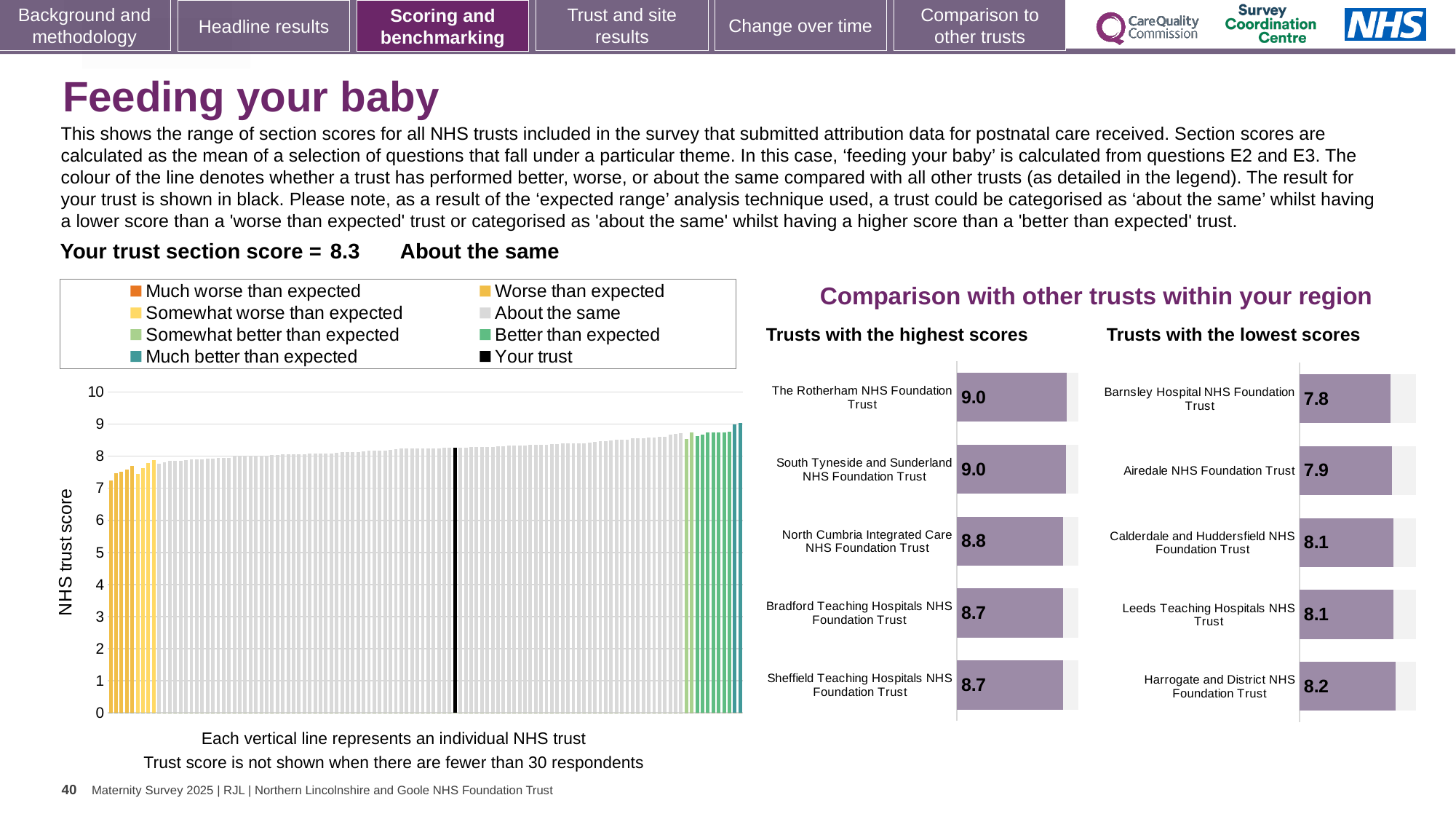
How many entries does the legend of the main 'NHS trust score' chart list? 8 In the 'Trusts with the highest scores' chart, what is the score for North Cumbria Integrated Care NHS Foundation Trust? 8.8 In the 'Trusts with the lowest scores' chart, which has the higher score: Airedale NHS Foundation Trust or Calderdale and Huddersfield NHS Foundation Trust? Calderdale and Huddersfield NHS Foundation Trust In the main 'NHS trust score' chart, do the values rise or fall from left to right? Rise What is the section score for your trust shown on the slide? 8.3 In the main 'NHS trust score' chart, is the value of the leftmost bar greater or less than 8? less How many trusts are shown in the 'Trusts with the highest scores' chart? 5 In the 'Trusts with the lowest scores' chart, which trust has the highest score? Harrogate and District NHS Foundation Trust In the 'Trusts with the lowest scores' chart, what is the difference between the scores of Harrogate and District NHS Foundation Trust and Barnsley Hospital NHS Foundation Trust? 0.4 In the 'Trusts with the lowest scores' chart, what is the score for Harrogate and District NHS Foundation Trust? 8.2 What kind of chart is the main 'NHS trust score' chart on the left? Bar chart In the 'Trusts with the lowest scores' chart, which trust has the lowest score? Barnsley Hospital NHS Foundation Trust